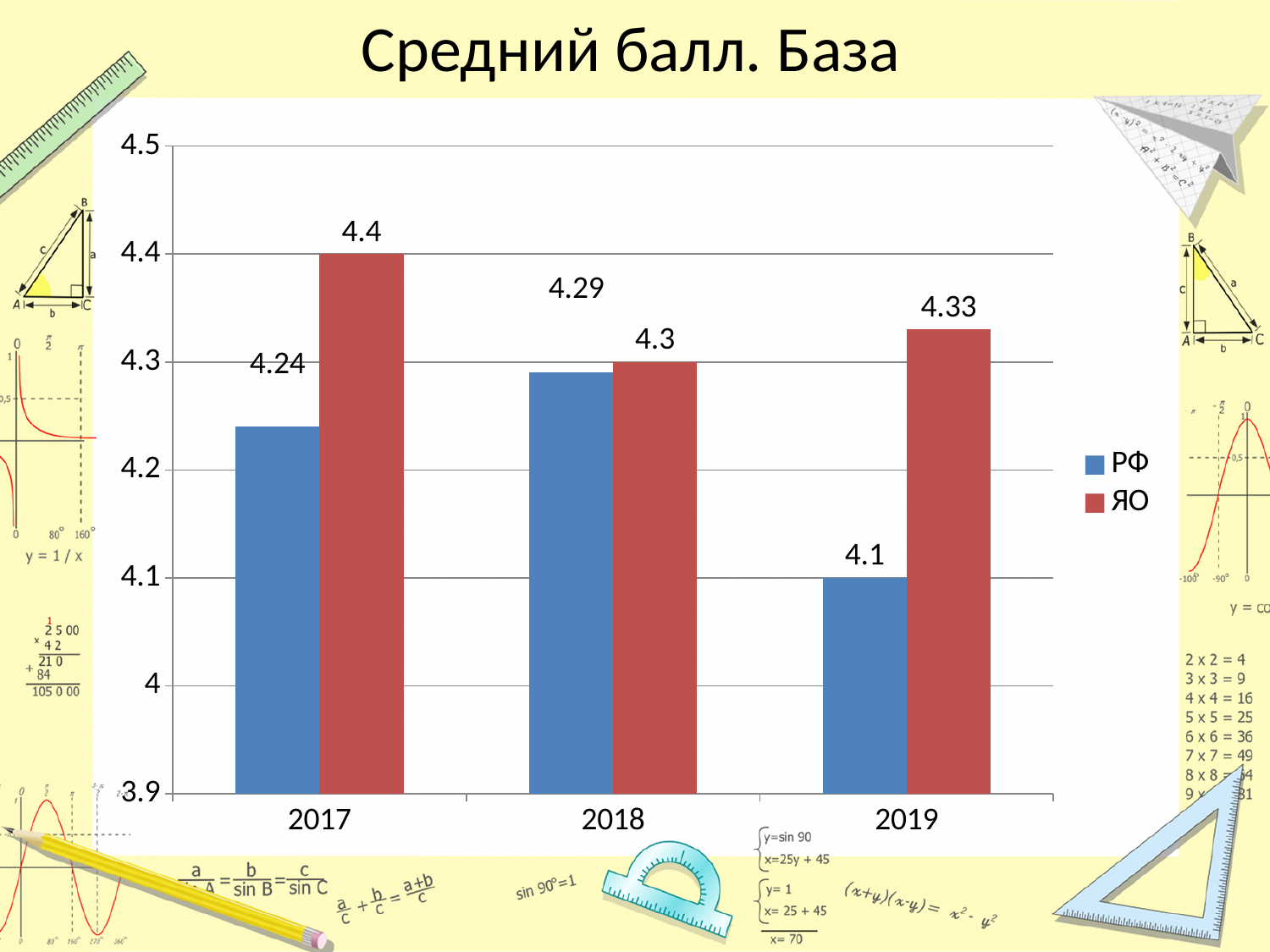
In which year is the РФ value lowest? 2019 How many series does the legend list? 2 Is the value for РФ in 2019 greater or less than 4.2? less What kind of chart is shown? bar chart What is the title of the chart? Средний балл. База Which is larger in 2017, РФ or ЯО? ЯО What is the difference between ЯО and РФ in 2019? 0.23 What is the value for РФ in 2017? 4.24 What is the value for РФ in 2018? 4.29 What is the value for ЯО in 2019? 4.33 In which year is the ЯО value highest? 2017 How many years are shown on the x axis? 3